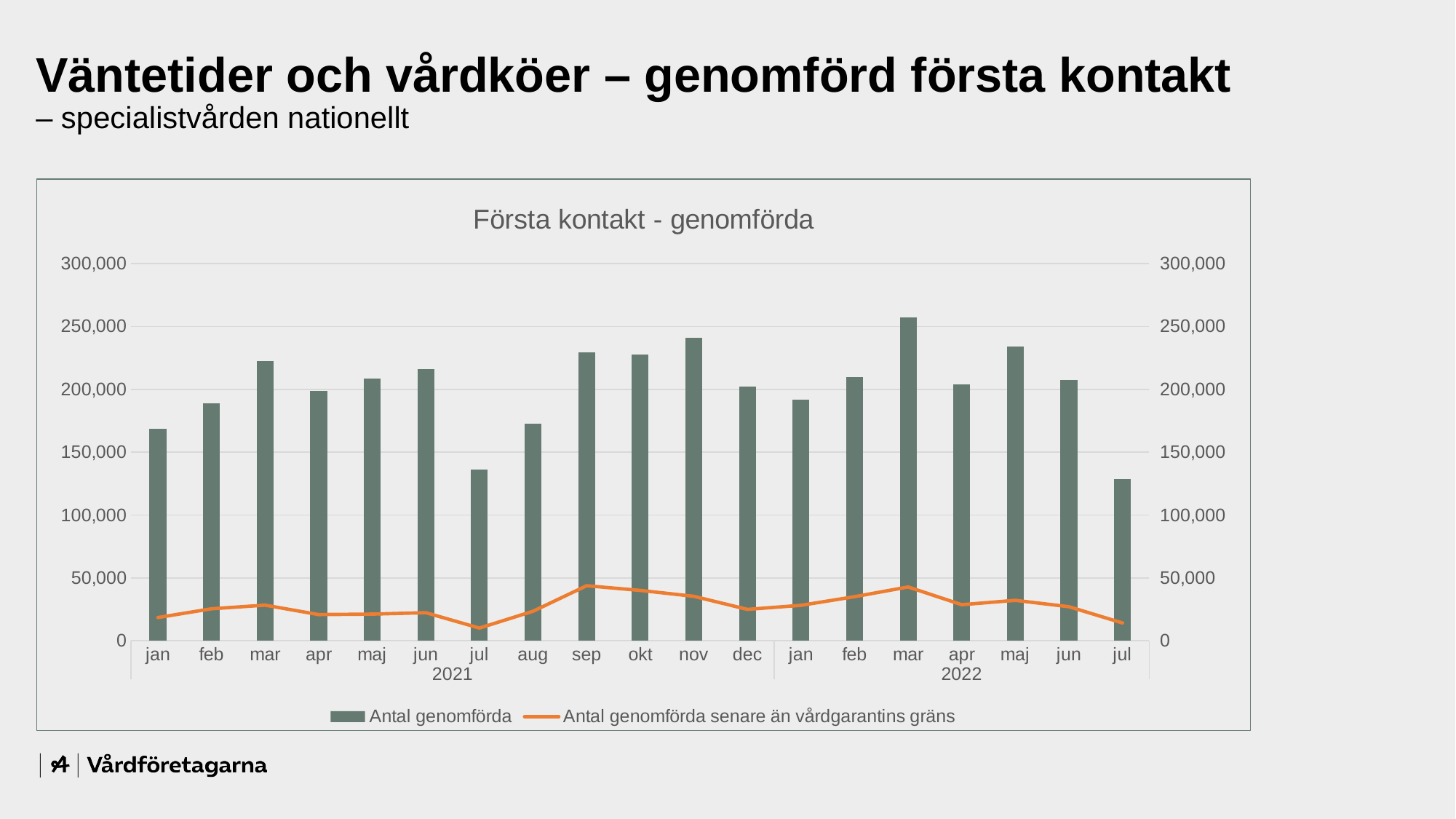
Which series is drawn as an orange line? Antal genomförda senare än vårdgarantins gräns Which month has the lowest bar for Antal genomförda? jul 2022 Do the Antal genomförda bars rise or fall from maj 2022 to jul 2022? fall Is the value for Antal genomförda in nov 2021 greater or less than 200,000? greater What is the title of the chart? Första kontakt - genomförda How many months (bars) are plotted on the x axis? 19 How many series does the legend list? 2 Which month has the highest bar for Antal genomförda? mar 2022 Which is larger for Antal genomförda: mar 2021 or apr 2021? mar 2021 Is the value for Antal genomförda in mar 2022 greater or less than 250,000? greater Is the value for Antal genomförda in jul 2021 greater or less than 150,000? less What kind of chart is shown? A bar chart combined with a line